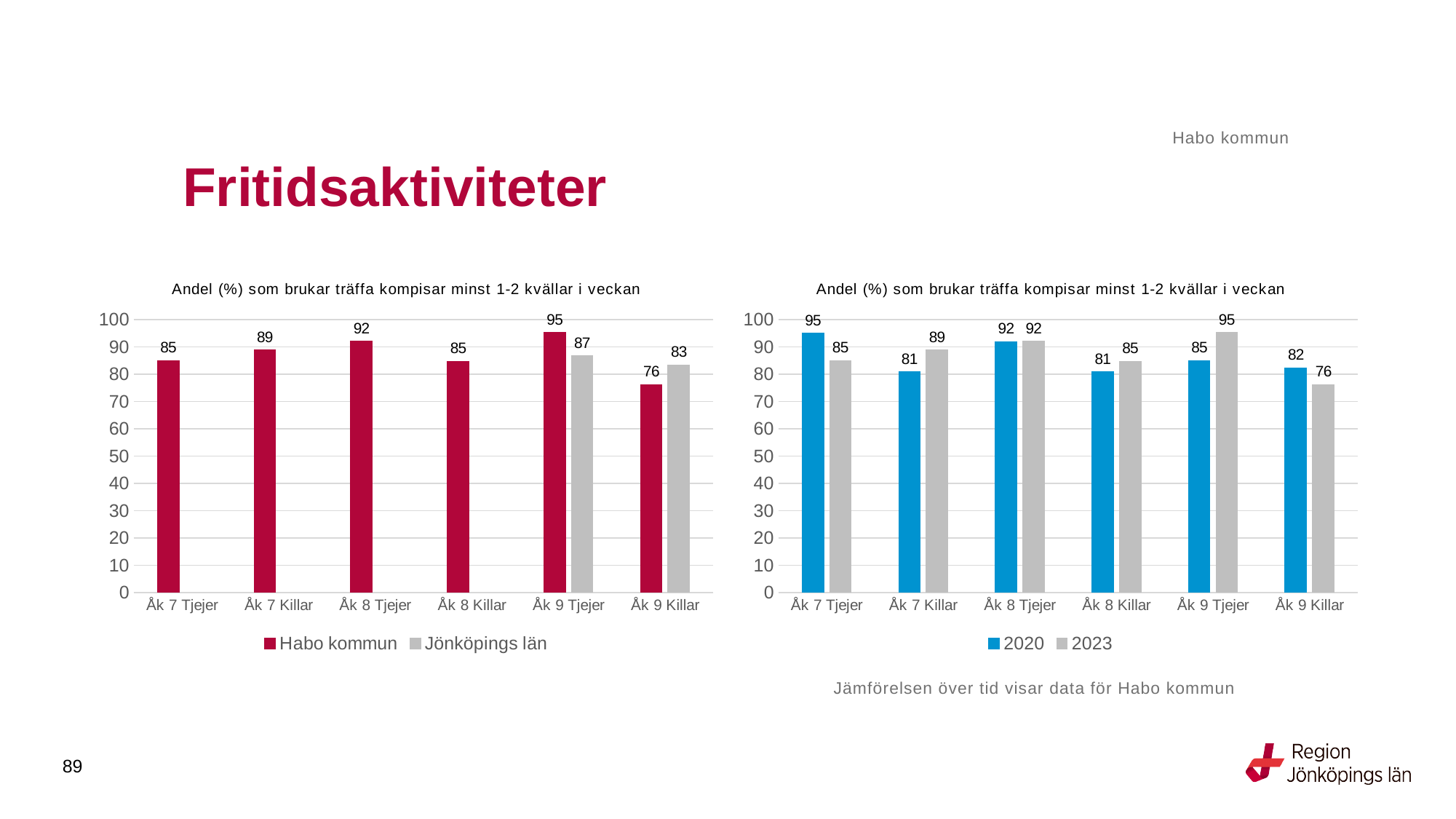
In the left chart, how many series does the legend list? 2 In the right chart, what is the value for 2023 for Åk 7 Killar? 89 In the left chart, which category has the lowest value for Habo kommun? Åk 9 Killar In the left chart, what is the value for Habo kommun for Åk 9 Tjejer? 95 In the right chart, what is the value for 2020 for Åk 7 Tjejer? 95 In the right chart, which is larger for Åk 9 Killar, 2020 or 2023? 2020 In the left chart, what is the value for Jönköpings län for Åk 9 Killar? 83 In the right chart, which category has the highest value for 2023? Åk 9 Tjejer How many categories are shown on the x axis of the right chart? 6 In the left chart, what is the difference between Habo kommun and Jönköpings län for Åk 9 Tjejer? 8 In the right chart, what is the difference between 2020 and 2023 for Åk 7 Tjejer? 10 What kind of chart is the left chart? Bar chart